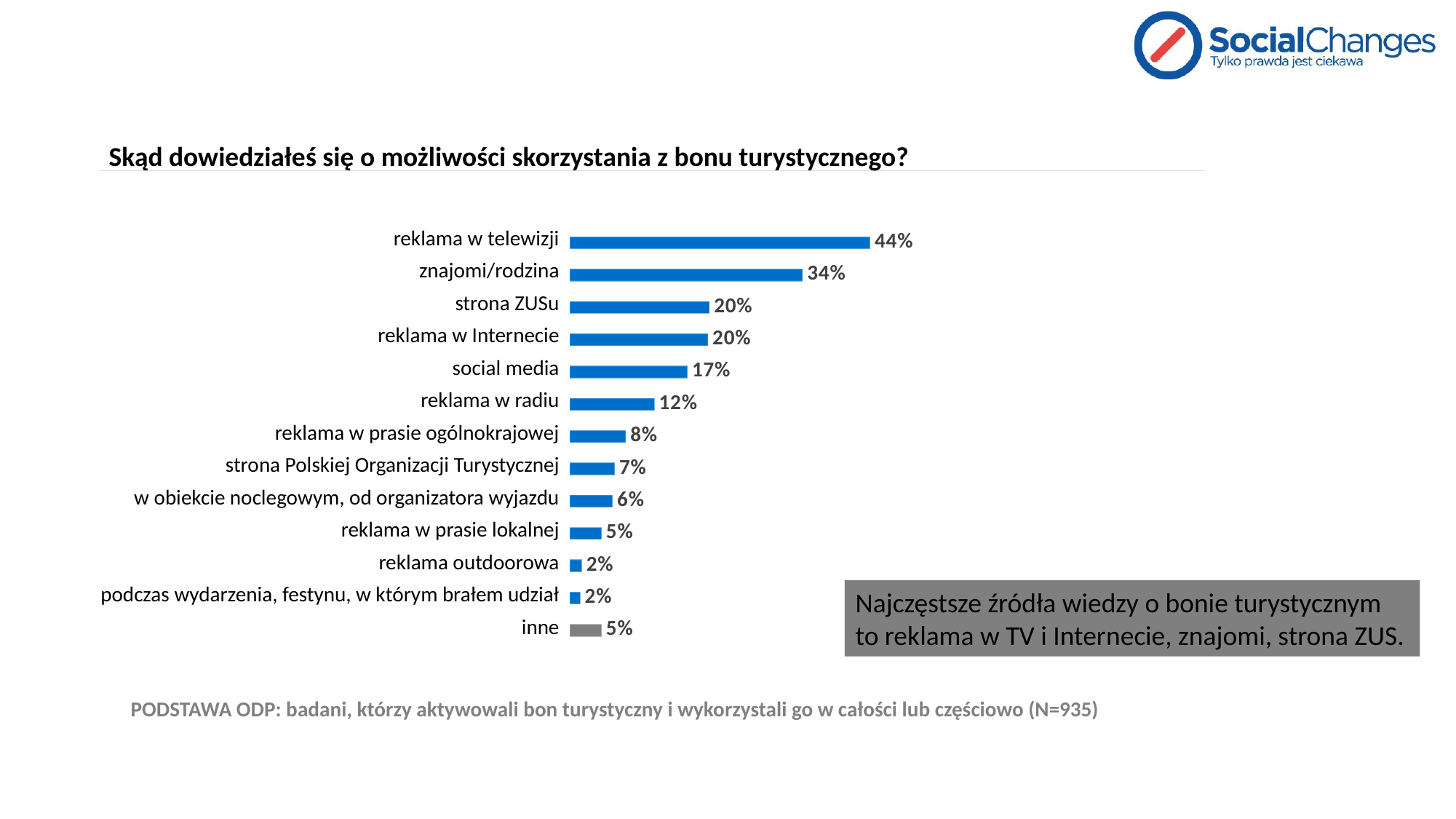
What is the value for "social media"? 17% Which is larger, the value for "social media" or the value for "reklama w prasie ogólnokrajowej"? social media What is the value for "znajomi/rodzina"? 34% What is the value for "inne"? 5% What is the value for "reklama w radiu"? 12% How many categories are shown in the chart? 13 What is the value for "reklama w telewizji"? 44% What kind of chart is shown on the slide? bar chart What is the difference between the values for "reklama w telewizji" and "znajomi/rodzina"? 10% What is the difference between the values for "strona ZUSu" and "reklama w radiu"? 8% Which category has the highest value? reklama w telewizji What is the title of the chart? Skąd dowiedziałeś się o możliwości skorzystania z bonu turystycznego?